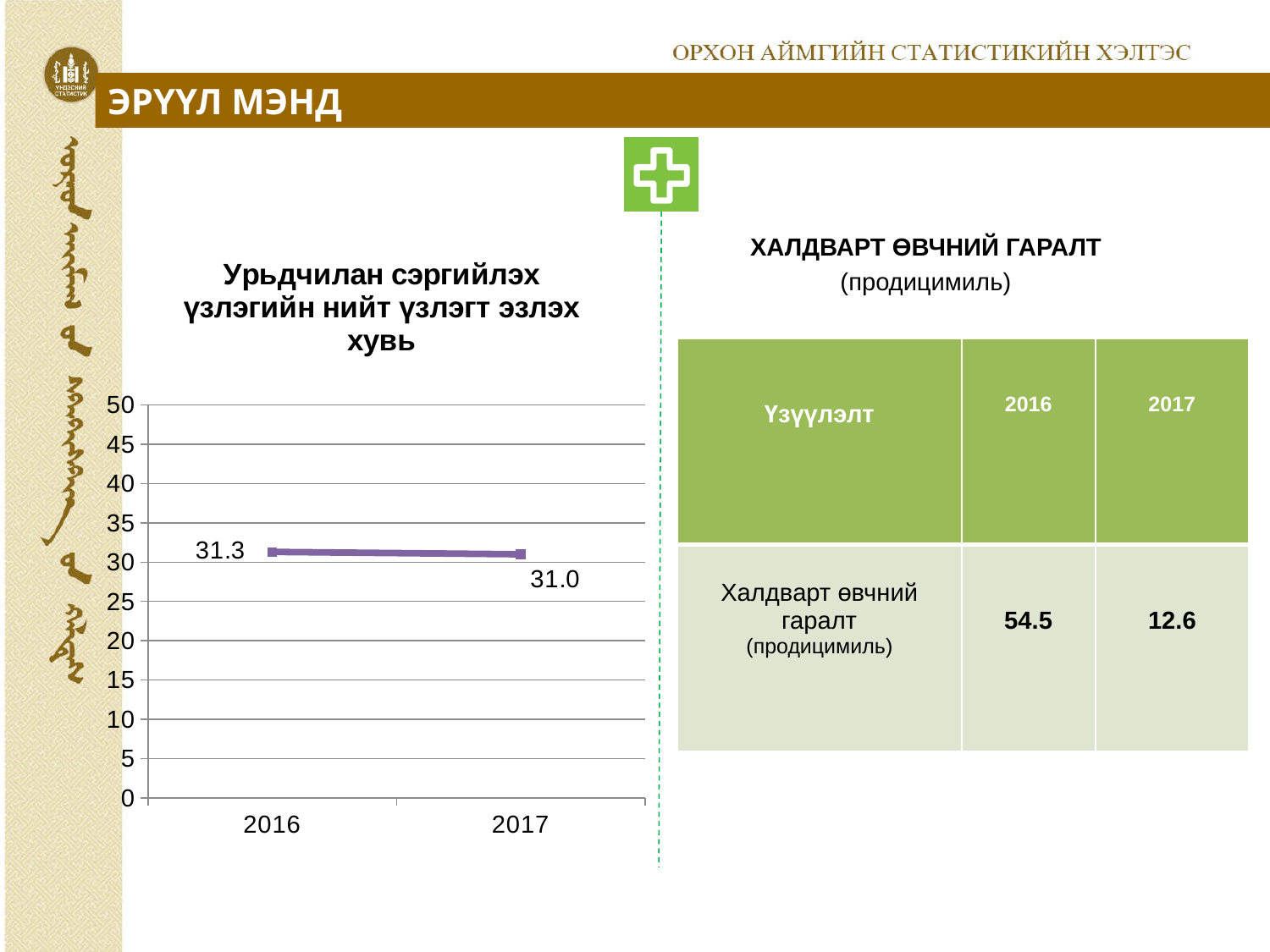
What is the value for 2016 in the chart? 31.3 What is the maximum value shown on the chart's vertical axis? 50 Do the values in the chart rise or fall from 2016 to 2017? fall Which year has the lowest value in the chart? 2017 Which year has the higher value in the chart, 2016 or 2017? 2016 What kind of chart is shown on the slide? line chart What is the difference between the 2016 and 2017 values in the chart? 0.3 Is the value for 2017 in the chart greater or less than 35? less Is the value for 2016 in the chart greater or less than 30? greater How many data points are plotted in the chart? 2 What is the value for 2017 in the chart? 31.0 What is the title of the chart? Урьдчилан сэргийлэх үзлэгийн нийт үзлэгт эзлэх хувь